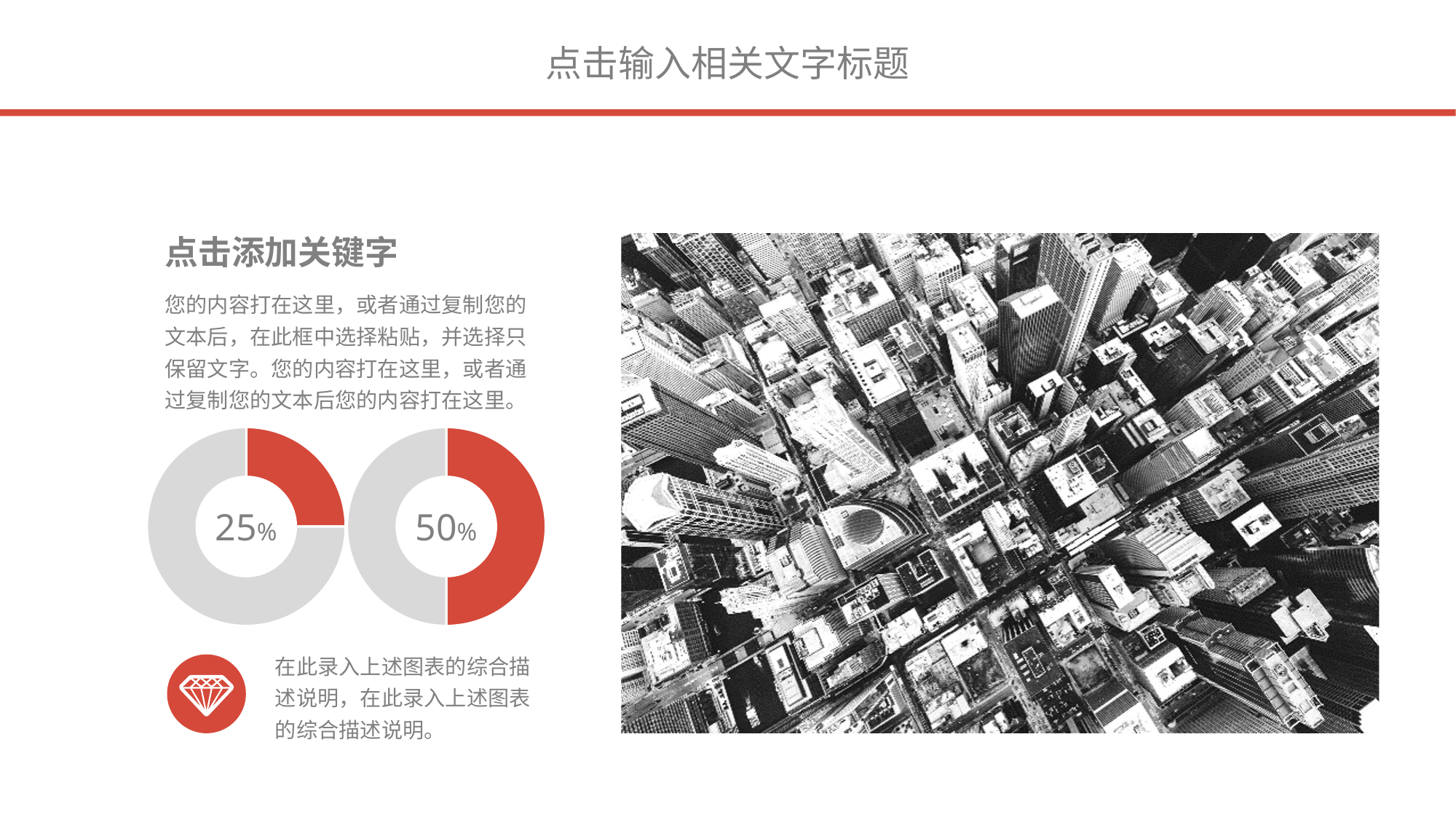
What is the difference between the value in the right donut chart and the value in the left donut chart? 25% Which of the two donut charts shows the larger value, the left or the right? the right In the left donut chart, what share of the ring is filled in red? 25% What value is printed in the centre of the right donut chart? 50% Is the value shown in the left donut chart greater or less than 50%? less How many segments does each donut chart have? 2 How many donut charts are on the slide? 2 What colour is the filled (highlighted) portion of the donut charts? red What kind of chart is used on the left side of the slide? donut chart What colour is the remaining portion of the donut charts? grey What value is printed in the centre of the left donut chart? 25% In the right donut chart, what share of the ring is filled in red? 50%